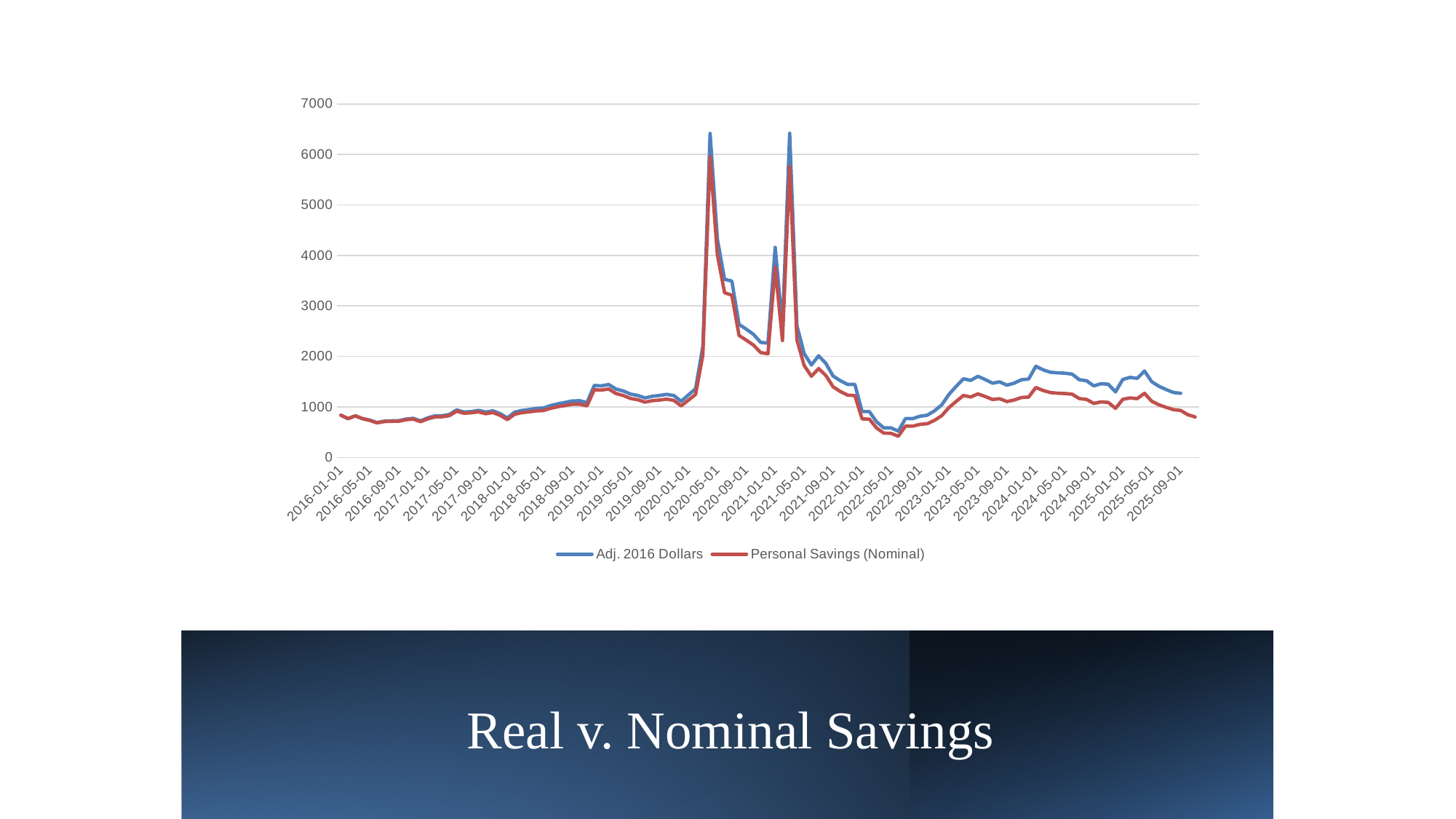
What is the title shown on the slide? Real v. Nominal Savings What are the two series named in the legend? Adj. 2016 Dollars and Personal Savings (Nominal) How many series does the legend list? 2 What kind of chart is shown on the slide? Line chart Around which x-axis label does the Personal Savings (Nominal) line reach its lowest point? 2022-05-01 Is the value of the Personal Savings (Nominal) line at 2016-01-01 greater or less than 1000? less Between 2021-05-01 and 2022-05-01, does the Adj. 2016 Dollars line rise or fall? fall Is the peak value of the Adj. 2016 Dollars line around 2020-05-01 greater or less than 6000? greater At 2025-09-01, which series has the higher value, Adj. 2016 Dollars or Personal Savings (Nominal)? Adj. 2016 Dollars Is the value of the Adj. 2016 Dollars line at 2024-01-01 greater or less than 1500? greater Which series reaches the highest peak on the chart? Adj. 2016 Dollars